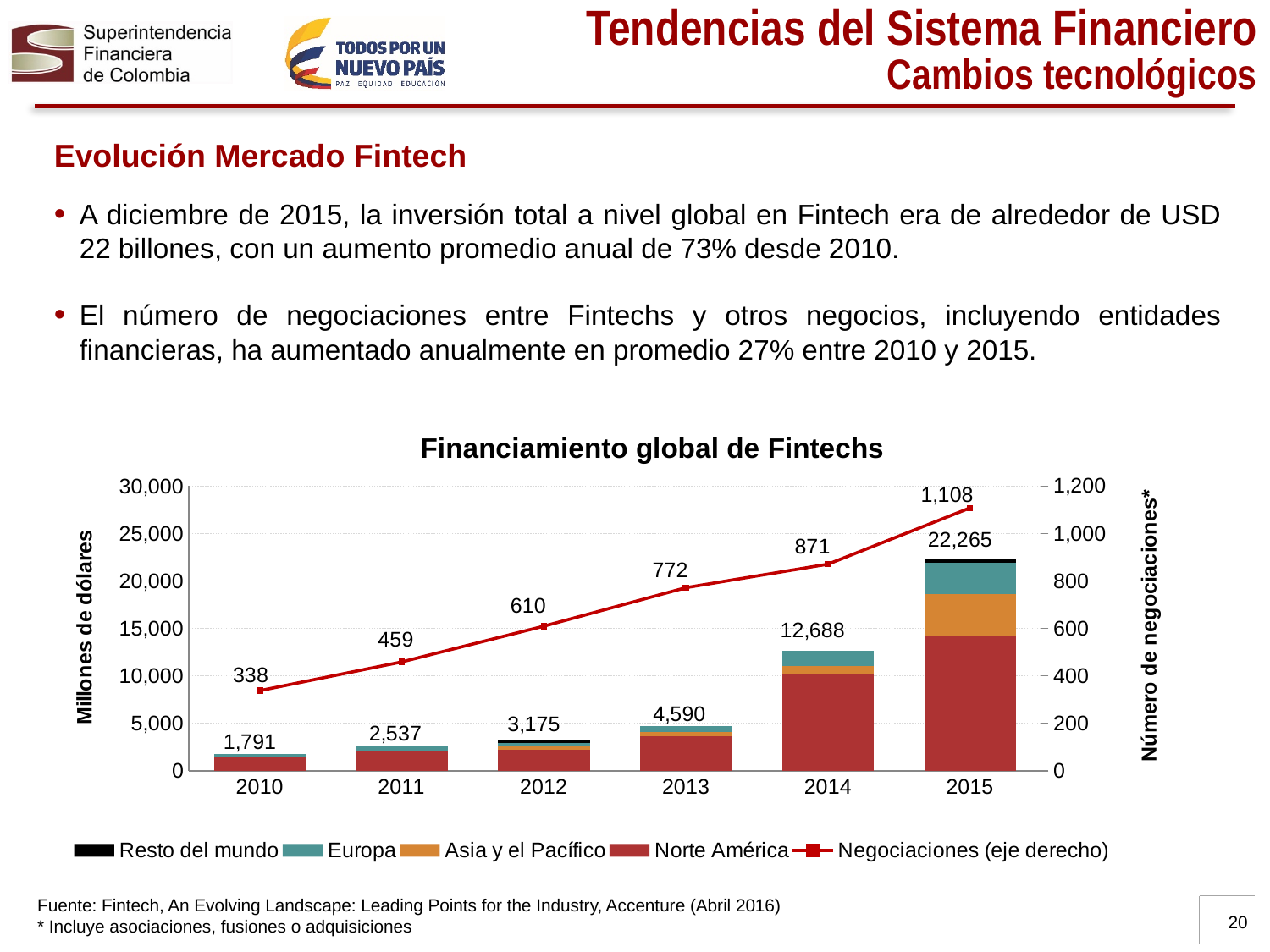
What is the total financing value labeled for 2012? 3,175 Which year has the highest number of negotiations? 2015 What is the total global Fintech financing shown for 2015? 22,265 Which year has the lowest total financing? 2010 How many years are shown on the x axis? 6 How many negotiations (Negociaciones) are shown for 2013? 772 Which is larger, the total financing in 2013 or in 2014? 2014 Is the Norte América segment for 2015 greater or less than 10,000 million dollars? greater What is the difference in total financing between 2015 and 2014? 9,577 How many series does the legend list? 5 Do the number of negotiations rise or fall from 2010 to 2015? rise By how much did the number of negotiations increase from 2010 to 2011? 121